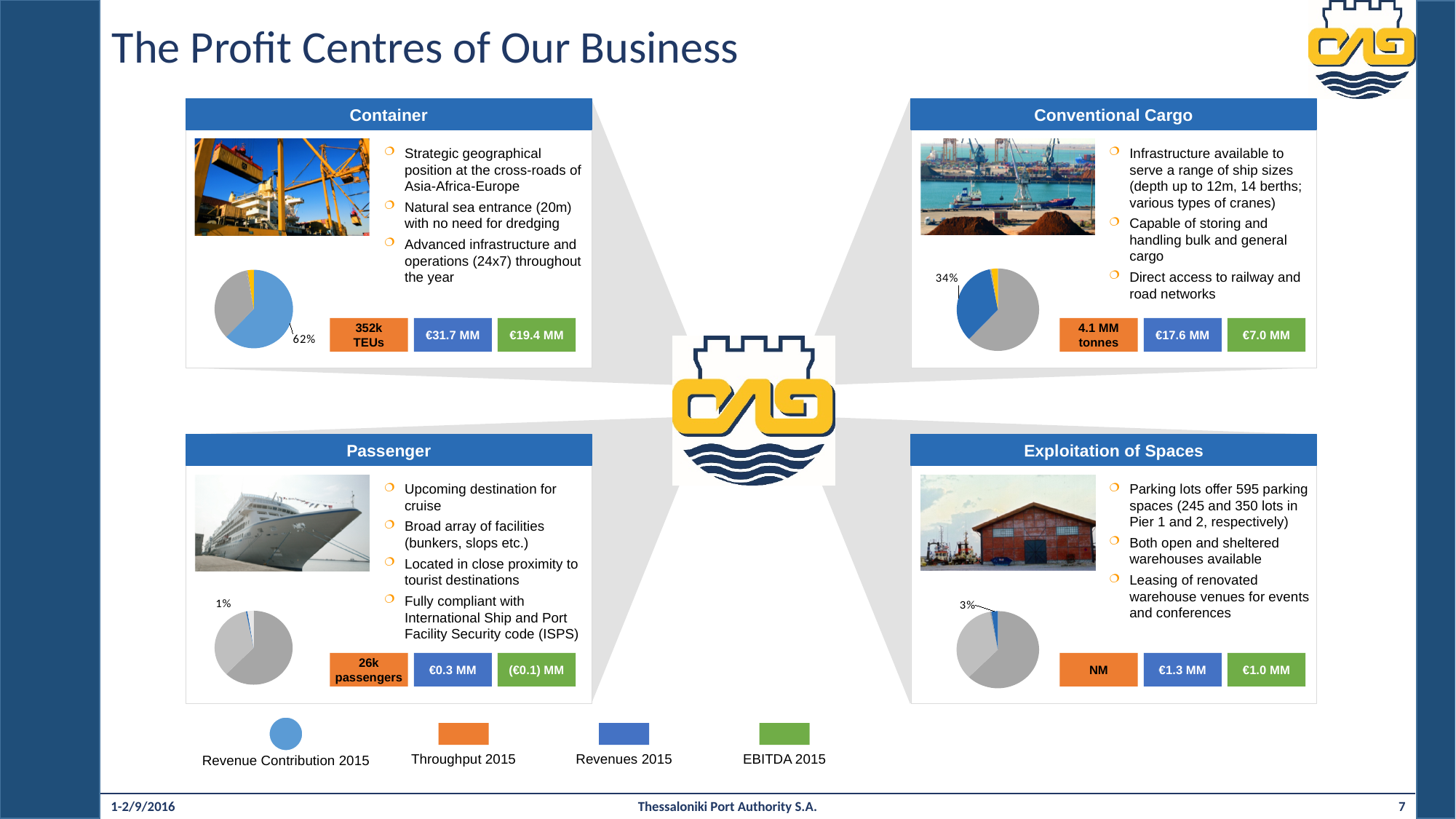
How many pie charts are shown on the slide? 4 Which profit centre's pie chart shows the smallest labelled revenue contribution share? Passenger According to the legend at the bottom of the slide, what do the pie charts represent? Revenue Contribution 2015 What is the difference in percentage points between the labelled share in the Container pie chart and the labelled share in the Conventional Cargo pie chart? 28 percentage points Is the labelled share in the Container pie chart larger or smaller than the labelled share in the Conventional Cargo pie chart? Larger In the Passenger panel's pie chart, what share is labelled on the highlighted slice? 1% What kind of chart is shown in each of the four profit centre panels? Pie chart In the Conventional Cargo panel's pie chart, what share is labelled on the highlighted slice? 34% Which profit centre's pie chart shows the largest labelled revenue contribution share? Container In the Container panel's pie chart, what share is labelled on the highlighted slice? 62% Is the labelled share in the Exploitation of Spaces pie chart larger or smaller than the labelled share in the Passenger pie chart? Larger